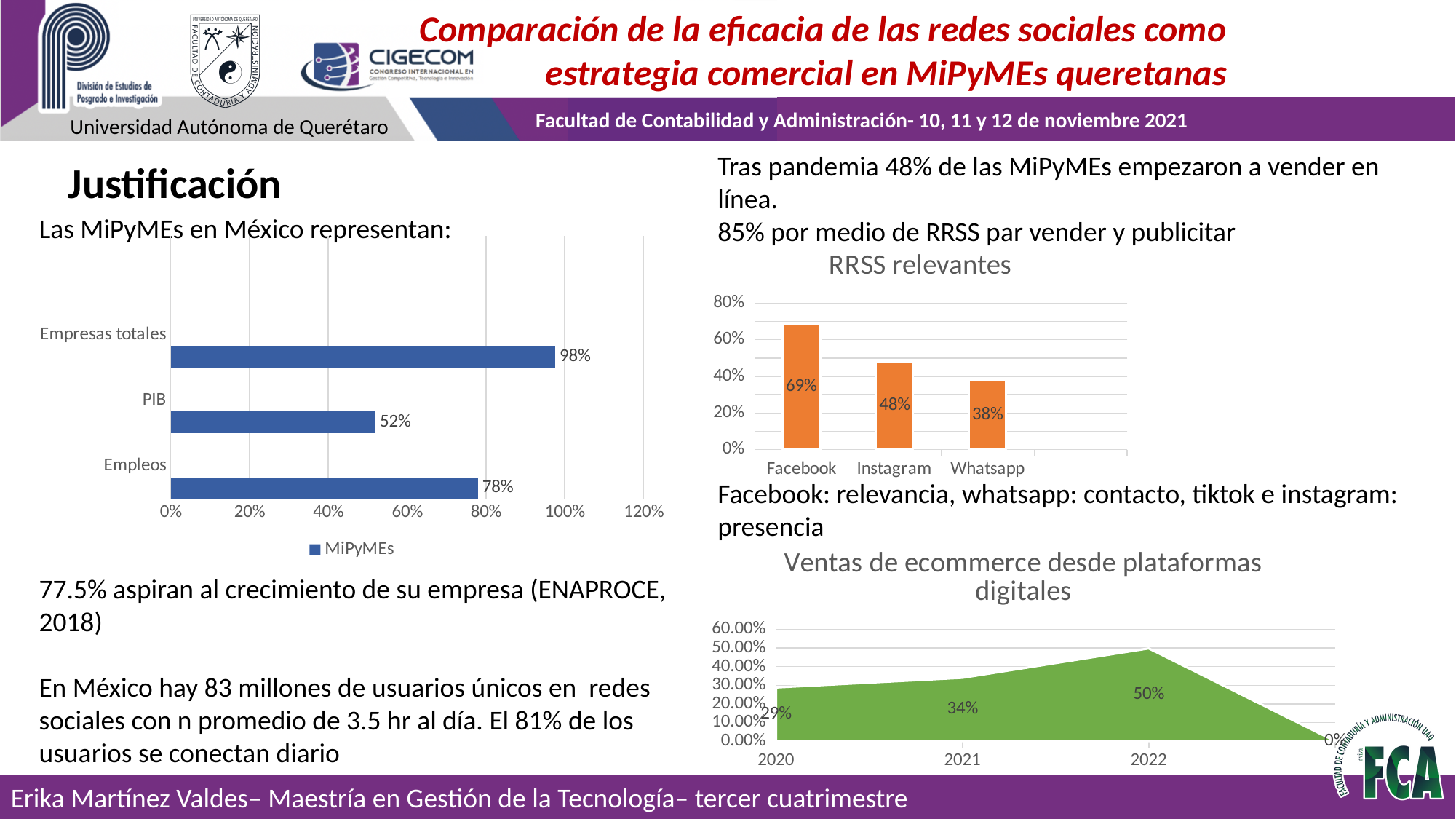
In the left bar chart, what series name does the legend show? MiPyMEs In the 'RRSS relevantes' chart, what is the difference between Facebook and Whatsapp? 31% What kind of chart is 'Ventas de ecommerce desde plataformas digitales'? area chart In the 'Ventas de ecommerce desde plataformas digitales' chart, what is the value for 2022? 50% In the left bar chart, what is the difference between Empresas totales and Empleos? 20% In the left bar chart, which category has the lowest value? PIB In the 'RRSS relevantes' chart, how many platforms are shown? 3 In the 'RRSS relevantes' chart, what is the value for Instagram? 48% In the 'Ventas de ecommerce desde plataformas digitales' chart, do the values rise or fall from 2020 to 2022? rise In the left bar chart, what is the value for Empresas totales? 98% In the 'RRSS relevantes' chart, which platform has the highest value? Facebook In the left bar chart, what is the value for PIB? 52%